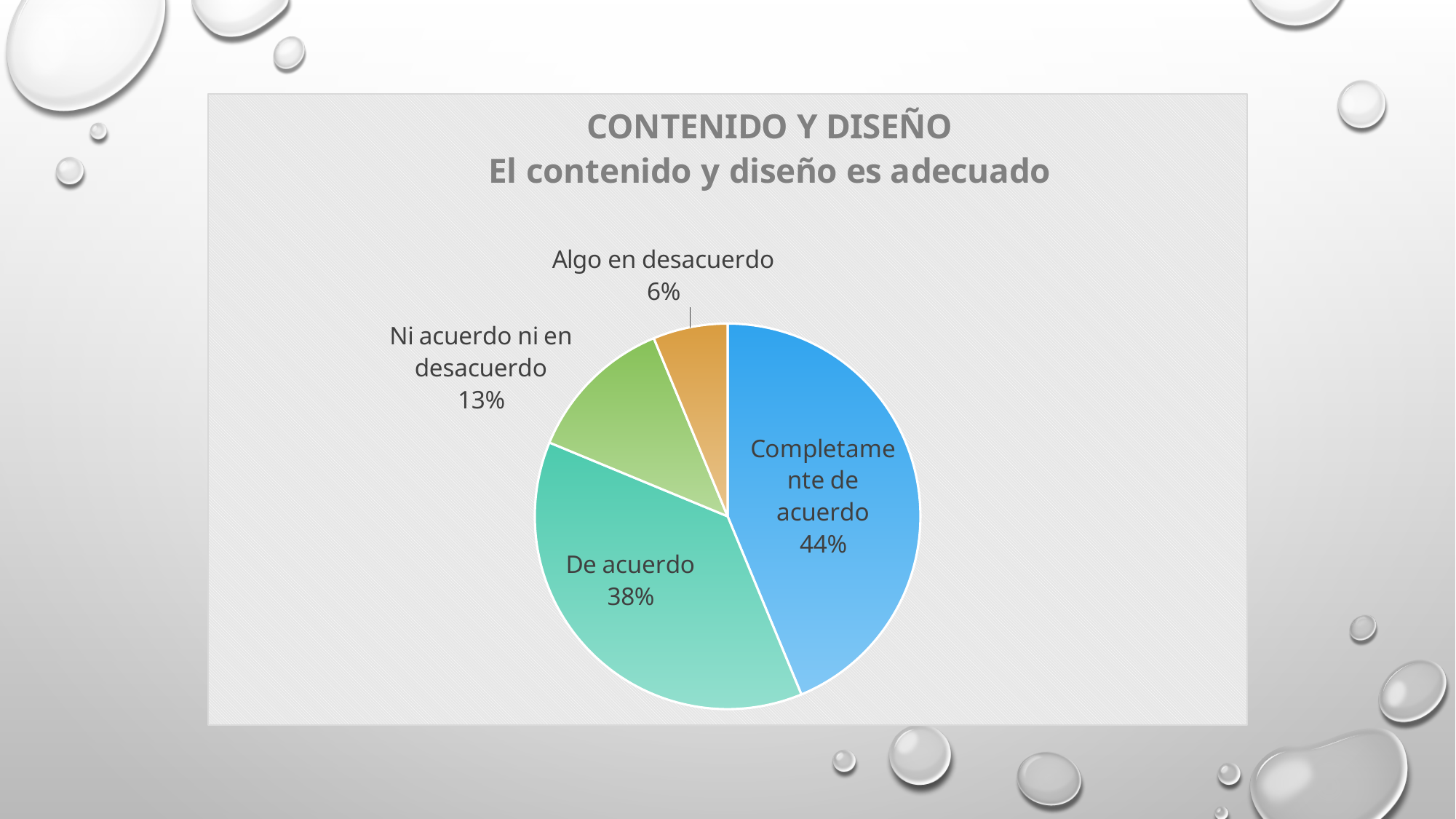
What is the title of the chart? CONTENIDO Y DISEÑO El contenido y diseño es adecuado Which is larger, 'Ni acuerdo ni en desacuerdo' or 'Algo en desacuerdo'? Ni acuerdo ni en desacuerdo What colour is the 'De acuerdo' slice? green (teal) What share of the pie is 'Completamente de acuerdo'? 44% Which category has the largest slice of the pie? Completamente de acuerdo What share of the pie is 'De acuerdo'? 38% What kind of chart is shown on the slide? pie chart What share of the pie is 'Ni acuerdo ni en desacuerdo'? 13% What is the difference in percentage points between 'Completamente de acuerdo' and 'De acuerdo'? 6 Which category has the smallest slice of the pie? Algo en desacuerdo How many slices does the pie chart have? 4